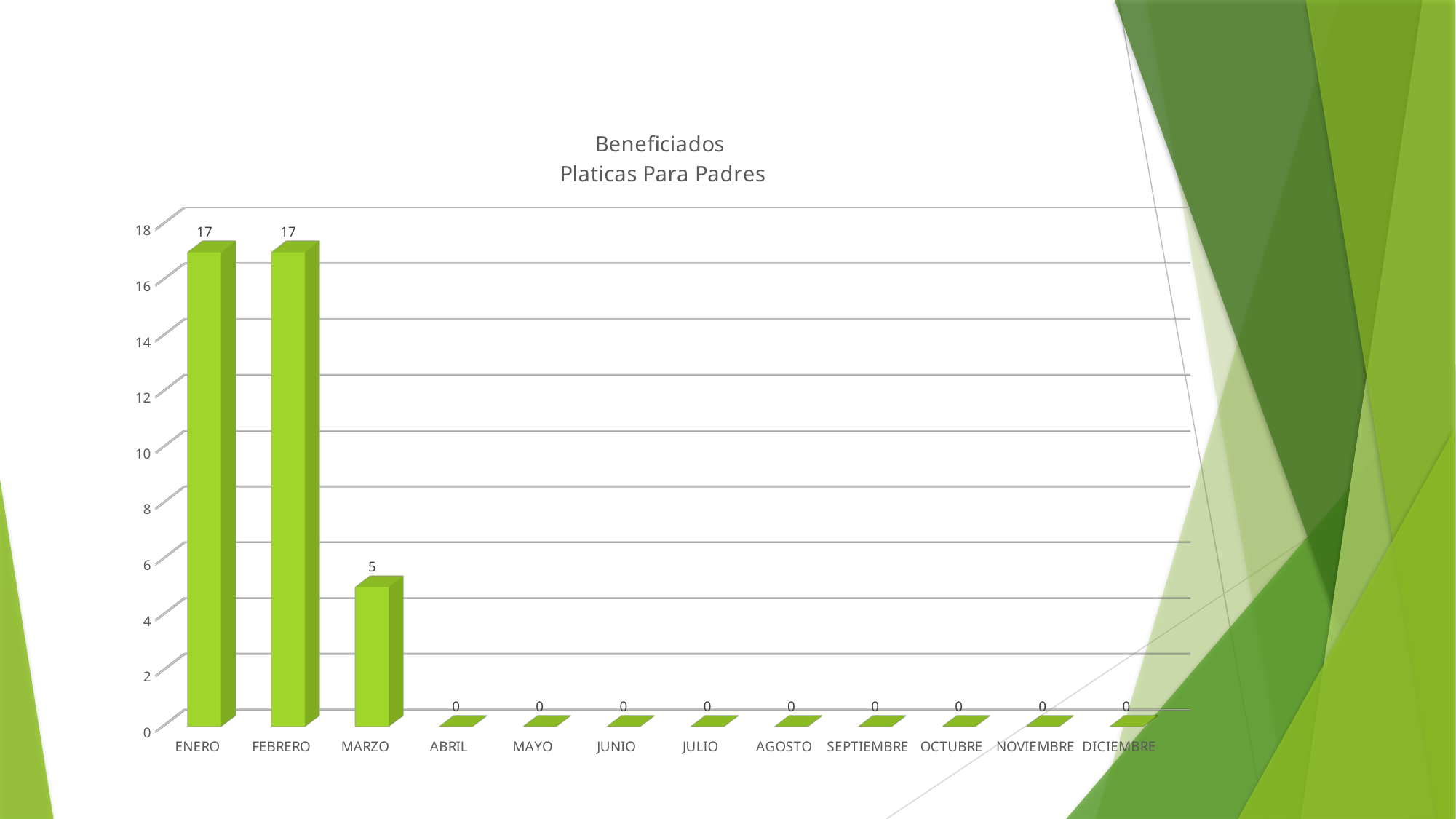
Is the value for MARZO greater or less than 10? less Do the values rise or fall from ENERO to ABRIL? fall How many months are shown on the x axis? 12 What is the value for ABRIL? 0 What is the value for MARZO? 5 What is the value for FEBRERO? 17 What is the difference between the values for ENERO and MARZO? 12 Which is larger, the value for FEBRERO or the value for MARZO? FEBRERO What is the value for ENERO? 17 What kind of chart is shown on the slide? bar chart What is the title of the chart? Beneficiados Platicas Para Padres Which month has the lowest value that is not zero? MARZO